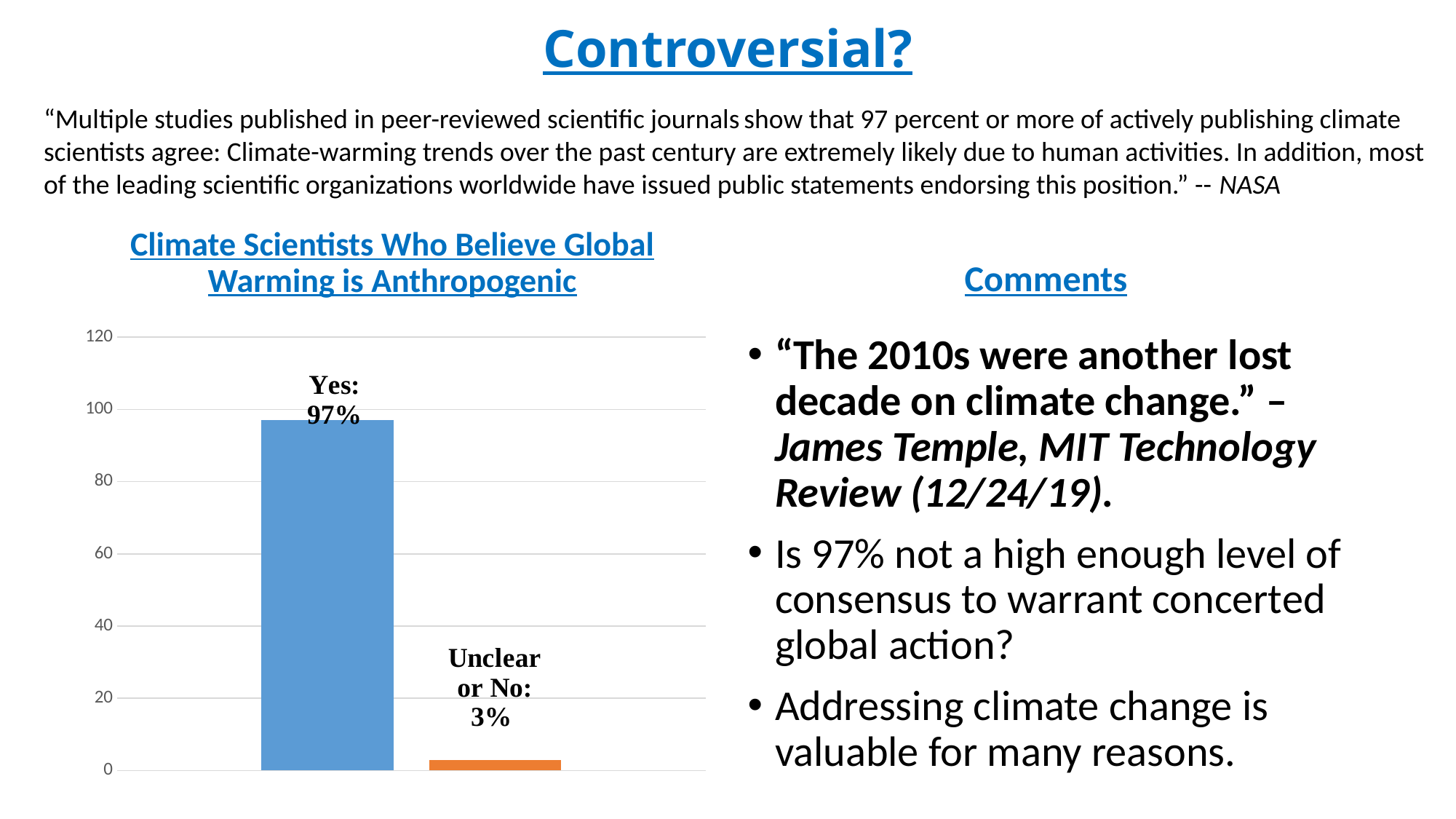
What is the value for "Yes" in the chart? 97% What is the title of the chart? Climate Scientists Who Believe Global Warming is Anthropogenic What kind of chart is shown on the slide? Bar chart Is the value for "Yes" greater or less than 80? greater How many categories are shown in the chart? 2 Is the value for "Unclear or No" greater or less than 20? less Which category has the highest value in the chart? Yes Which category has the lowest value in the chart? Unclear or No Which is larger, the value for "Yes" or the value for "Unclear or No"? Yes What colour is the bar for "Yes"? Blue What is the value for "Unclear or No" in the chart? 3% What is the difference between the "Yes" value and the "Unclear or No" value? 94%